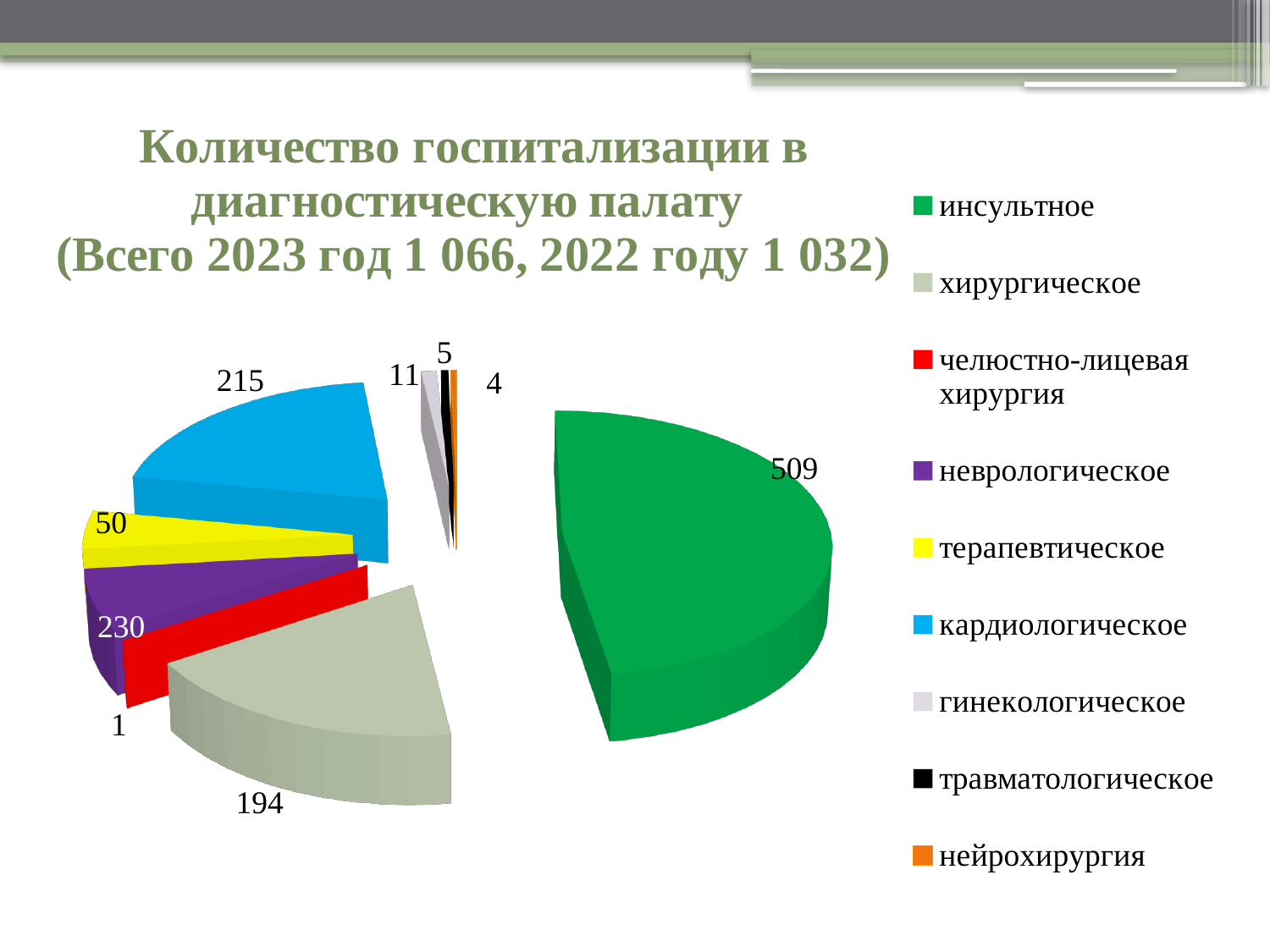
Which is larger, хирургическое or терапевтическое? хирургическое How many categories does the legend list? 9 What is the value for кардиологическое? 215 What is the value for инсультное? 509 Which is larger, неврологическое or кардиологическое? кардиологическое What colour is the slice for инсультное? green What is the difference between the values for инсультное and хирургическое? 315 What is the value for терапевтическое? 50 Which category has the largest slice of the pie? инсультное What kind of chart is shown on the slide? pie chart What is the value for хирургическое? 194